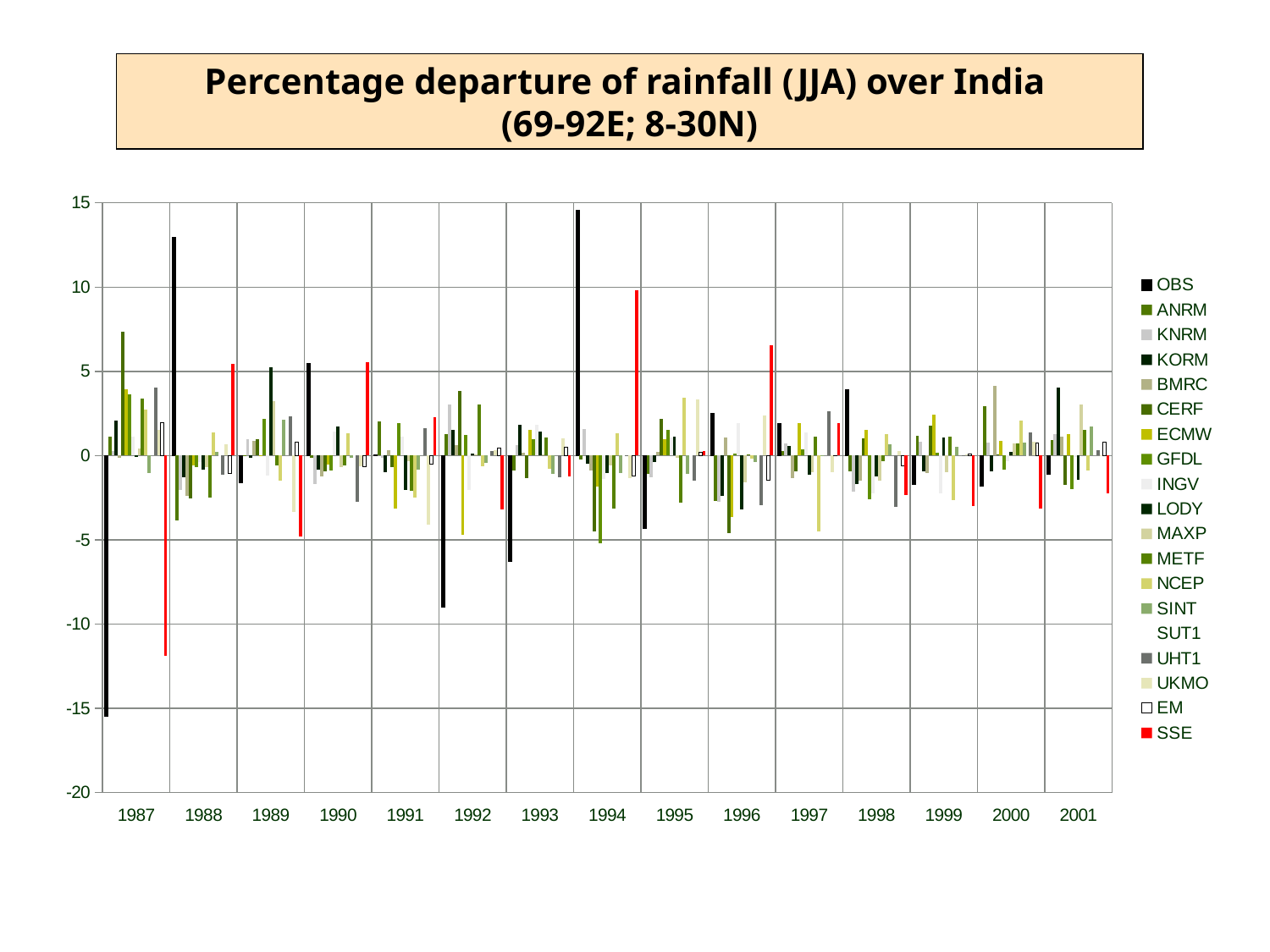
Which is larger, the OBS value for 1994 or the OBS value for 1988? 1994 Is the SSE value for 1988 greater or less than -10? greater Which year has the lowest OBS value? 1987 What kind of chart is shown on the slide? bar chart What is the title of the chart? Percentage departure of rainfall (JJA) over India (69-92E; 8-30N) How many years are shown along the x axis? 15 Is the SSE value for 1995 greater or less than 5? less Which year has the highest OBS value? 1994 Is the OBS value for 1994 greater or less than 10? greater How many series does the legend list? 19